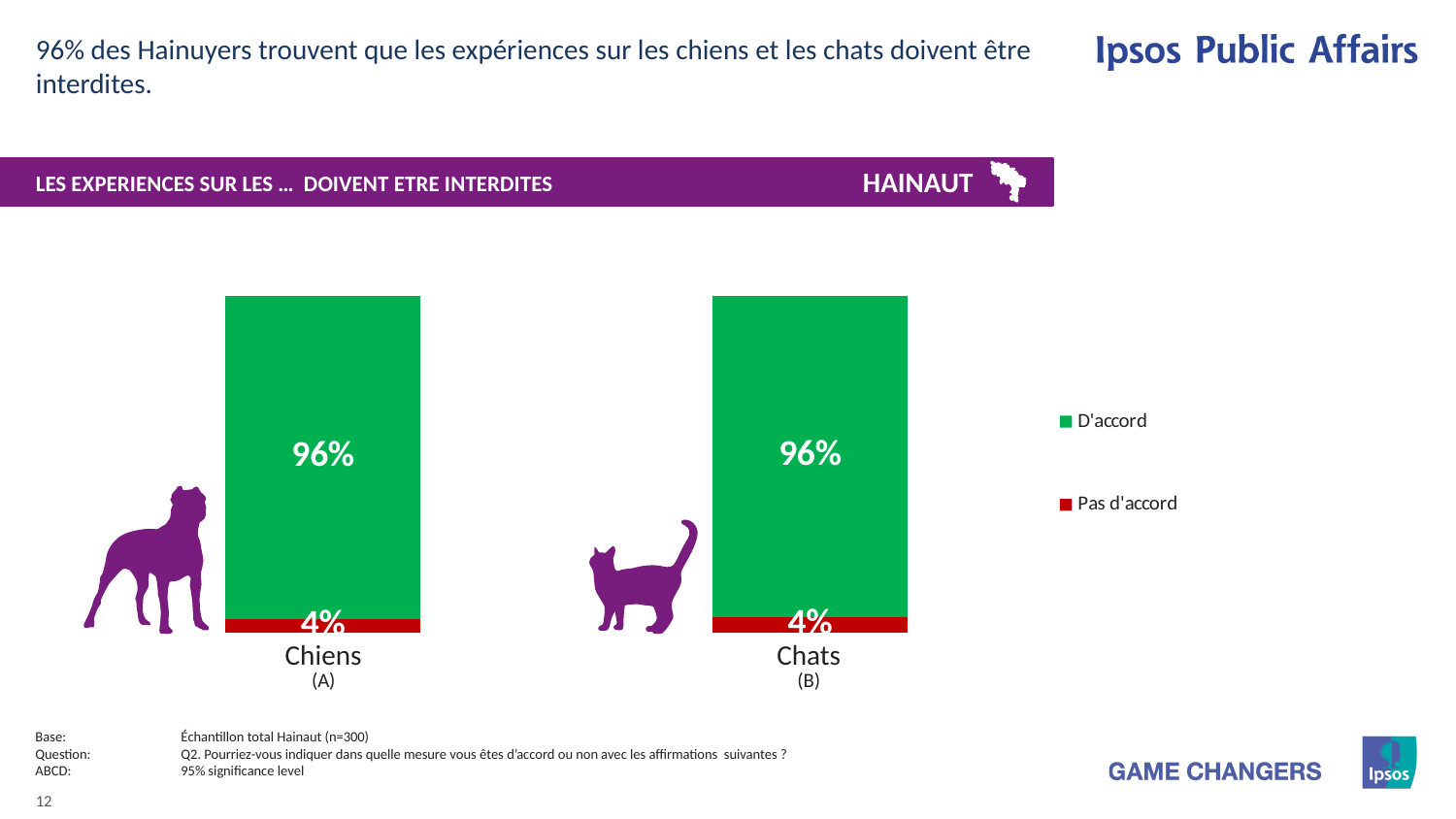
Which colour represents "Pas d'accord" in the chart? Red What percentage of respondents are "Pas d'accord" for Chiens? 4% How many series does the legend list? 2 Which is larger for Chats: "D'accord" or "Pas d'accord"? D'accord What kind of chart is shown on the slide? Stacked bar chart What is the difference between the "D'accord" and "Pas d'accord" values for Chiens? 92% What percentage of respondents are "D'accord" for Chiens? 96% What is the total of the stacked bar for Chiens? 100% What is the title of the chart? LES EXPERIENCES SUR LES … DOIVENT ETRE INTERDITES How many categories are shown on the x axis of the chart? 2 What percentage of respondents are "Pas d'accord" for Chats? 4% What percentage of respondents are "D'accord" for Chats? 96%